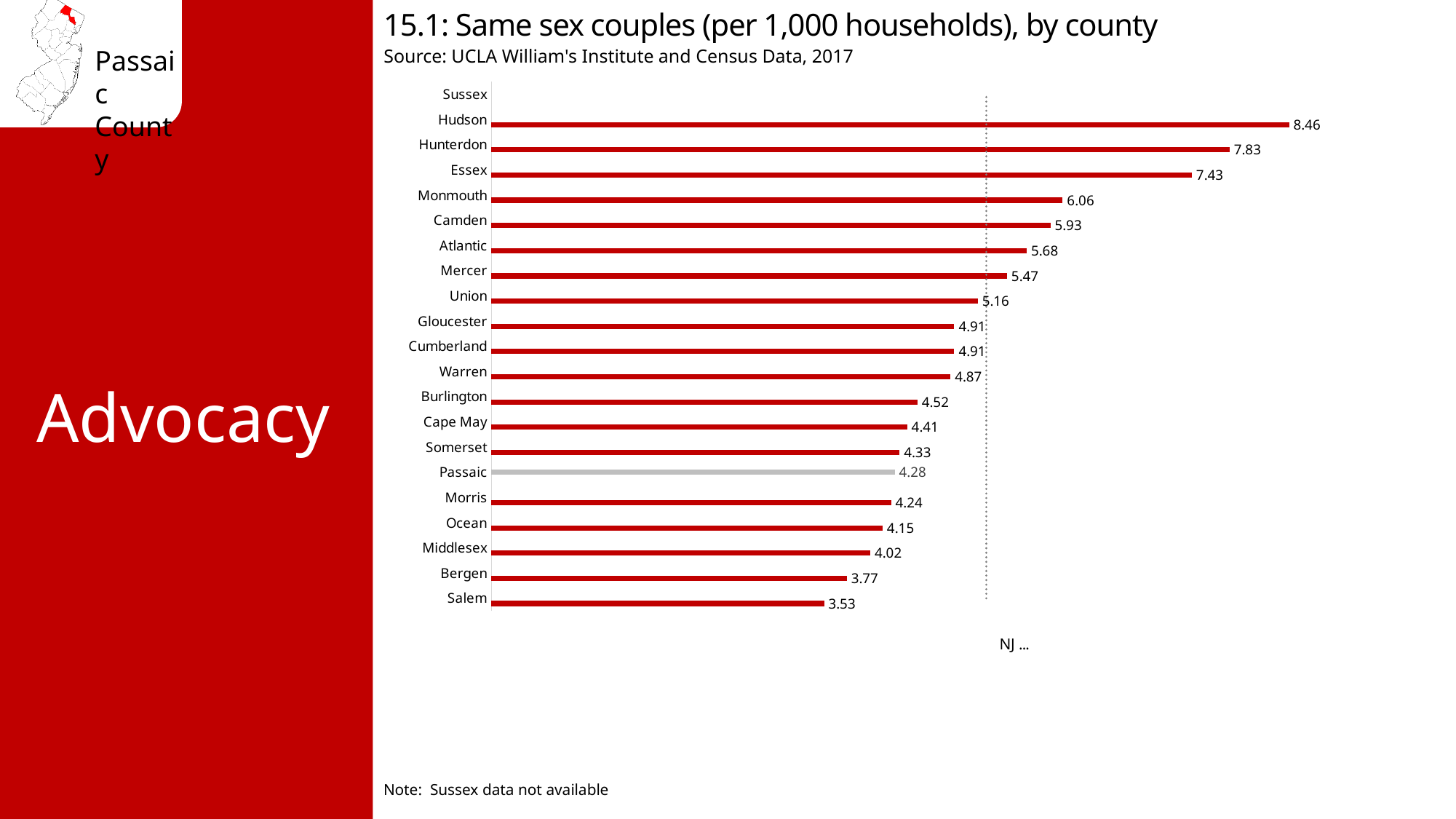
Which county has the highest value of same sex couples per 1,000 households? Hudson Which has a higher value, Bergen or Middlesex? Middlesex Which county's bar is shown in grey rather than red? Passaic What is the difference between the values for Passaic and Salem? 0.75 Which has a higher value, Essex or Monmouth? Essex How many counties are listed on the chart's axis? 21 Which county with data shown has the lowest value? Salem What is the value for Salem? 3.53 What is the value for Passaic in the chart of same sex couples per 1,000 households? 4.28 What is the value for Hudson? 8.46 What type of chart is shown on the slide? Bar chart What is the difference between the values for Hudson and Hunterdon? 0.63